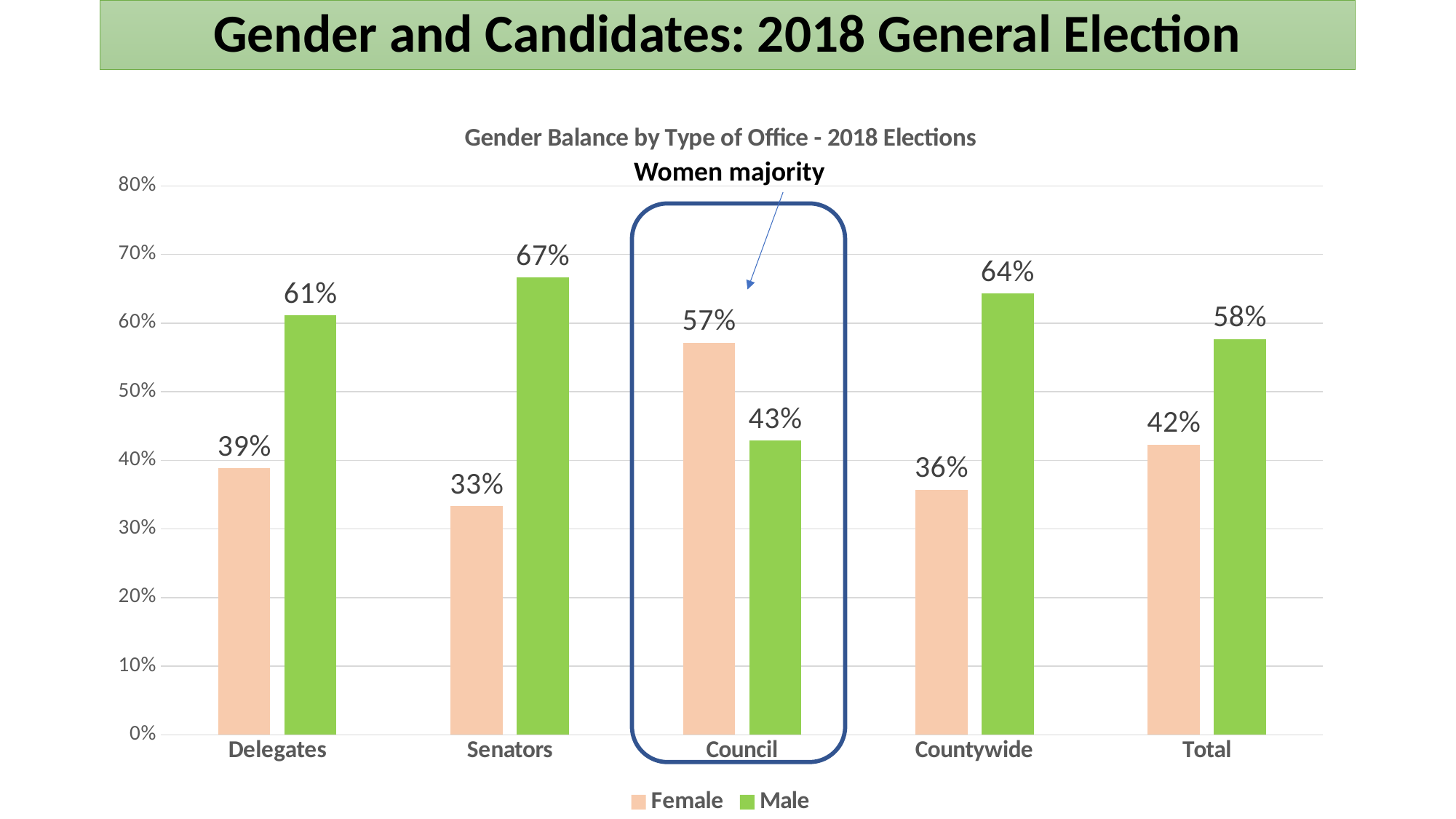
What is the Male value for Senators? 67% Which category has the lowest Female value? Senators Which is larger for Council, the Female value or the Male value? Female What is the title of the chart? Gender Balance by Type of Office - 2018 Elections Is the Male value for Total greater or less than 50%? greater How many series does the legend list? 2 How many categories are shown on the x axis? 5 What kind of chart is shown on the slide? Bar chart What is the Female value for Countywide? 36% What is the difference between the Male and Female values for Delegates? 22% What is the Female value for Council? 57% Which category has the highest Male value? Senators